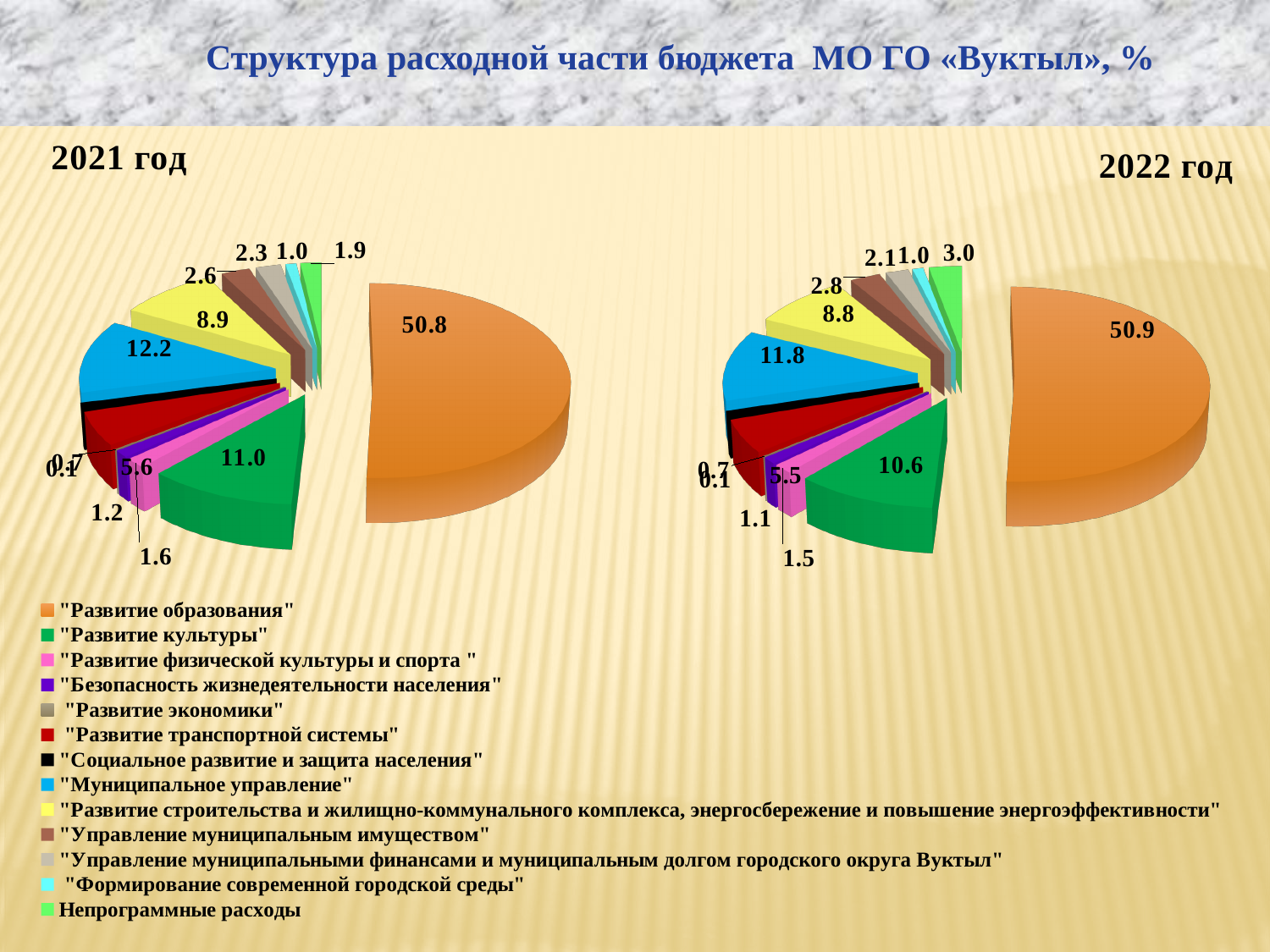
In the 2021 год pie chart, which category has the largest share? "Развитие образования" By how much does the "Развитие образования" share in the 2022 год chart exceed that in the 2021 год chart? 0.1 In the 2022 год pie chart, what value is labelled on the "Развитие культуры" slice? 10.6 In the 2021 год pie chart, what share is shown for "Развитие образования"? 50.8 What type of chart is used for the 2021 год and 2022 год data? Pie chart In the 2021 год pie chart, which is larger: "Развитие культуры" or "Муниципальное управление"? "Муниципальное управление" In the 2022 год pie chart, what share is shown for "Развитие образования"? 50.9 In the 2022 год pie chart, what is the smallest value labelled on any slice? 0.1 In the 2021 год pie chart, what value is labelled on the "Муниципальное управление" slice? 12.2 What is the difference between the "Муниципальное управление" values in the 2021 год and 2022 год charts? 0.4 In the 2022 год pie chart, what value is labelled on the "Развитие строительства и жилищно-коммунального комплекса, энергосбережение и повышение энергоэффективности" slice? 8.8 How many categories does the legend list for the pie charts? 13